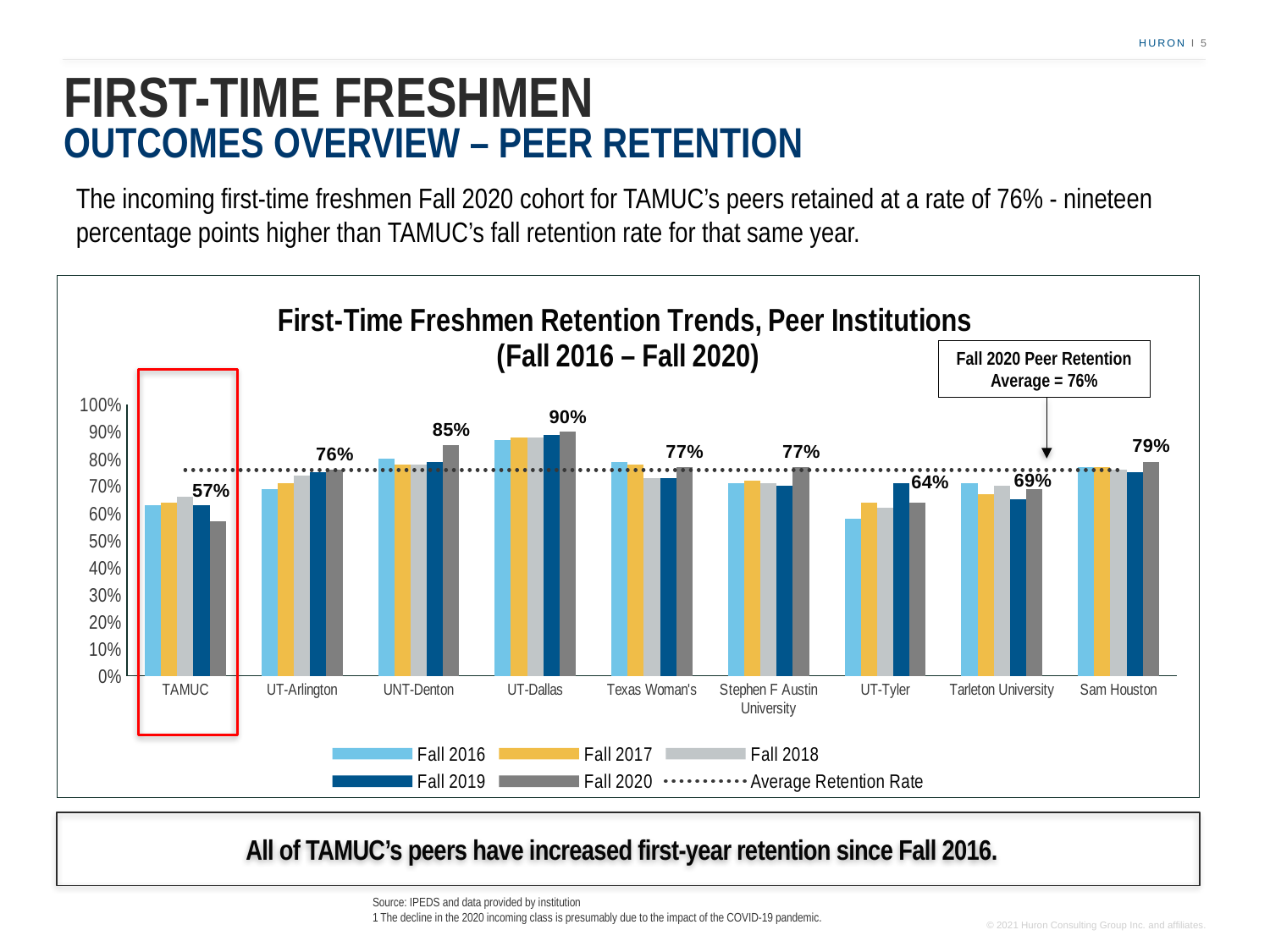
Which institution has the lowest labelled Fall 2020 retention rate? TAMUC Do UT-Arlington's retention bars rise or fall from Fall 2016 to Fall 2020? Rise How many institutions are shown on the x axis of the chart? 9 Is the Fall 2016 value for UT-Dallas greater or less than 80%? greater What is the Fall 2020 retention rate shown for UT-Dallas? 90% Which institution has the highest labelled Fall 2020 retention rate? UT-Dallas How many entries does the chart's legend list? 6 How many percentage points higher is UT-Dallas's Fall 2020 retention rate than TAMUC's? 33 percentage points Which has the higher Fall 2020 retention rate, Sam Houston or UT-Tyler? Sam Houston What is the Fall 2020 retention rate shown for TAMUC? 57% What Fall 2020 peer retention average is indicated by the dotted line on the chart? 76% What kind of chart is used to show the retention trends? Bar chart